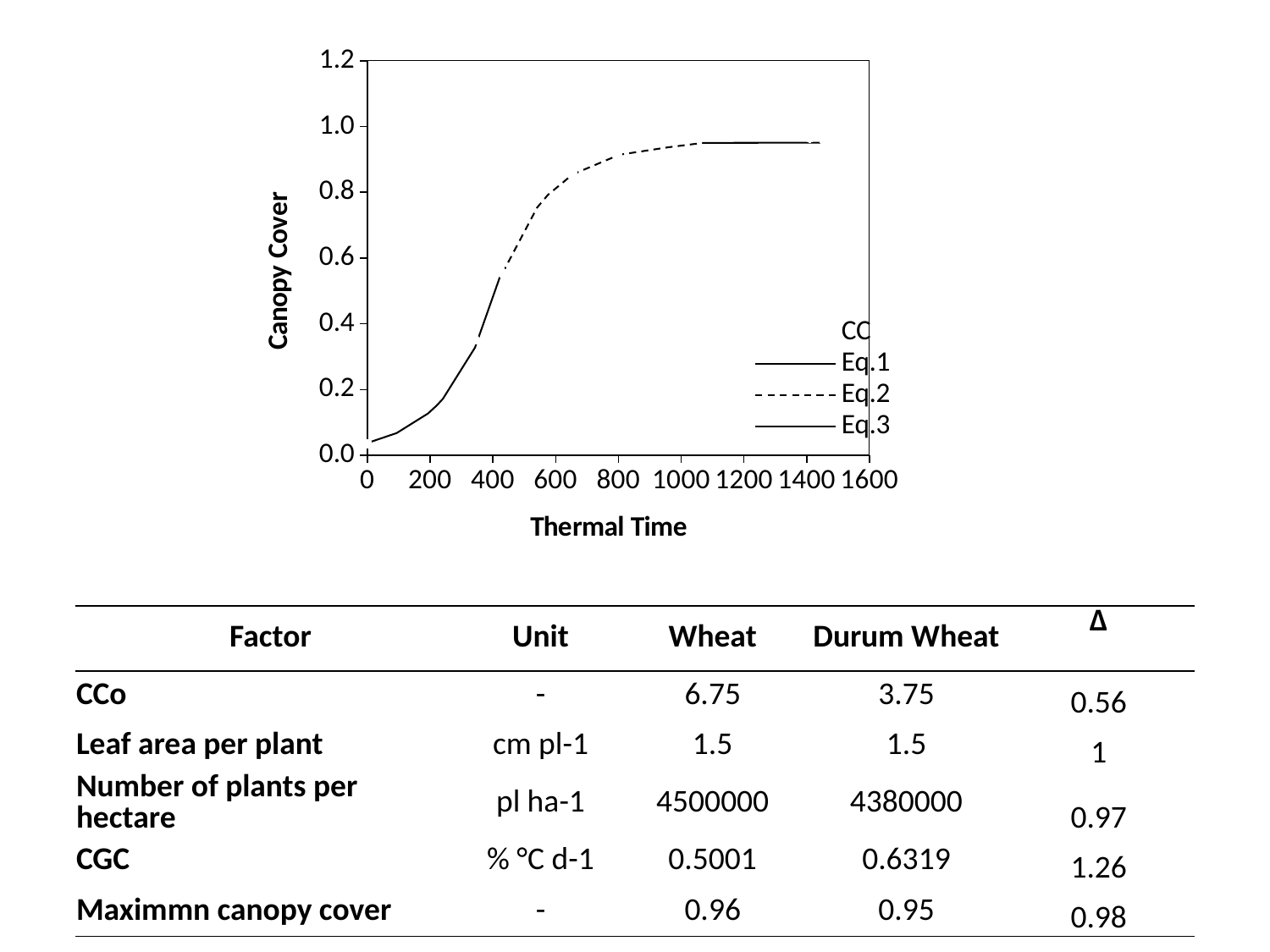
Do the canopy cover values rise or fall as thermal time increases along the x axis? rise What is the title of the x axis of the chart? Thermal Time What kind of chart is shown on the slide? line chart Is the canopy cover value at a thermal time of 200 greater or less than 0.2? less Is the canopy cover value at a thermal time of 400 greater or less than 0.2? greater Which series in the legend is drawn with a dashed line? Eq.2 Is the canopy cover value at a thermal time of 1400 greater or less than 0.8? greater How many series does the chart's legend list? 4